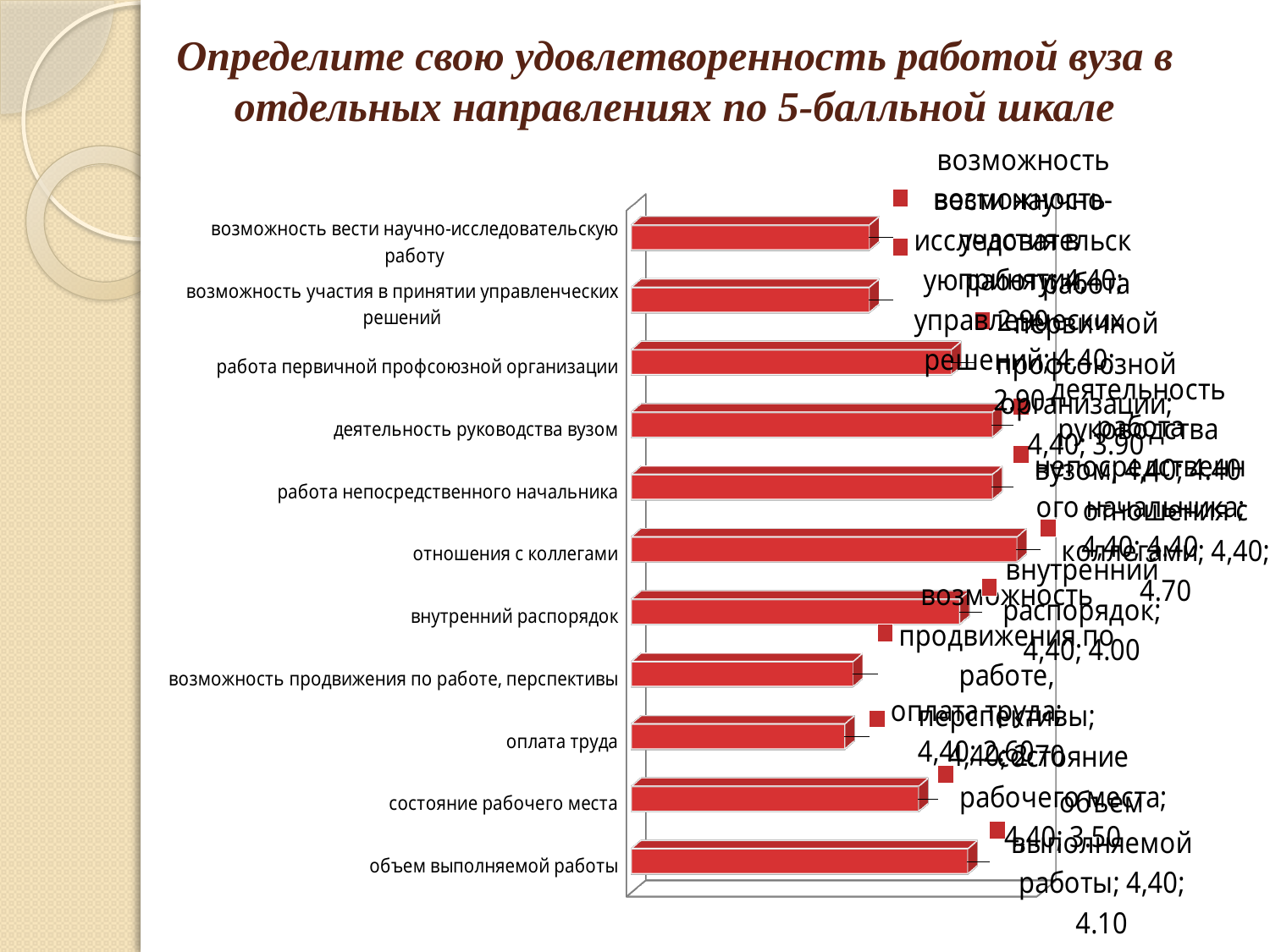
What is the value shown for "объем выполняемой работы"? 4,10 What is the title of the slide containing the chart? Определите свою удовлетворенность работой вуза в отдельных направлениях по 5-балльной шкале Which is larger: the value for "деятельность руководства вузом" or the value for "оплата труда"? деятельность руководства вузом What is the value shown for "внутренний распорядок"? 4,00 What colour are the bars in the chart? red What is the value shown for "отношения с коллегами"? 4,70 Which is larger: the value for "объем выполняемой работы" or the value for "состояние рабочего места"? объем выполняемой работы What kind of chart is shown on the slide? bar chart What is the value shown for "состояние рабочего места"? 3,50 Which category has the longest bar in the chart? отношения с коллегами How many categories are plotted in the chart? 11 What is the difference between the value for "отношения с коллегами" and the value for "внутренний распорядок"? 0,70